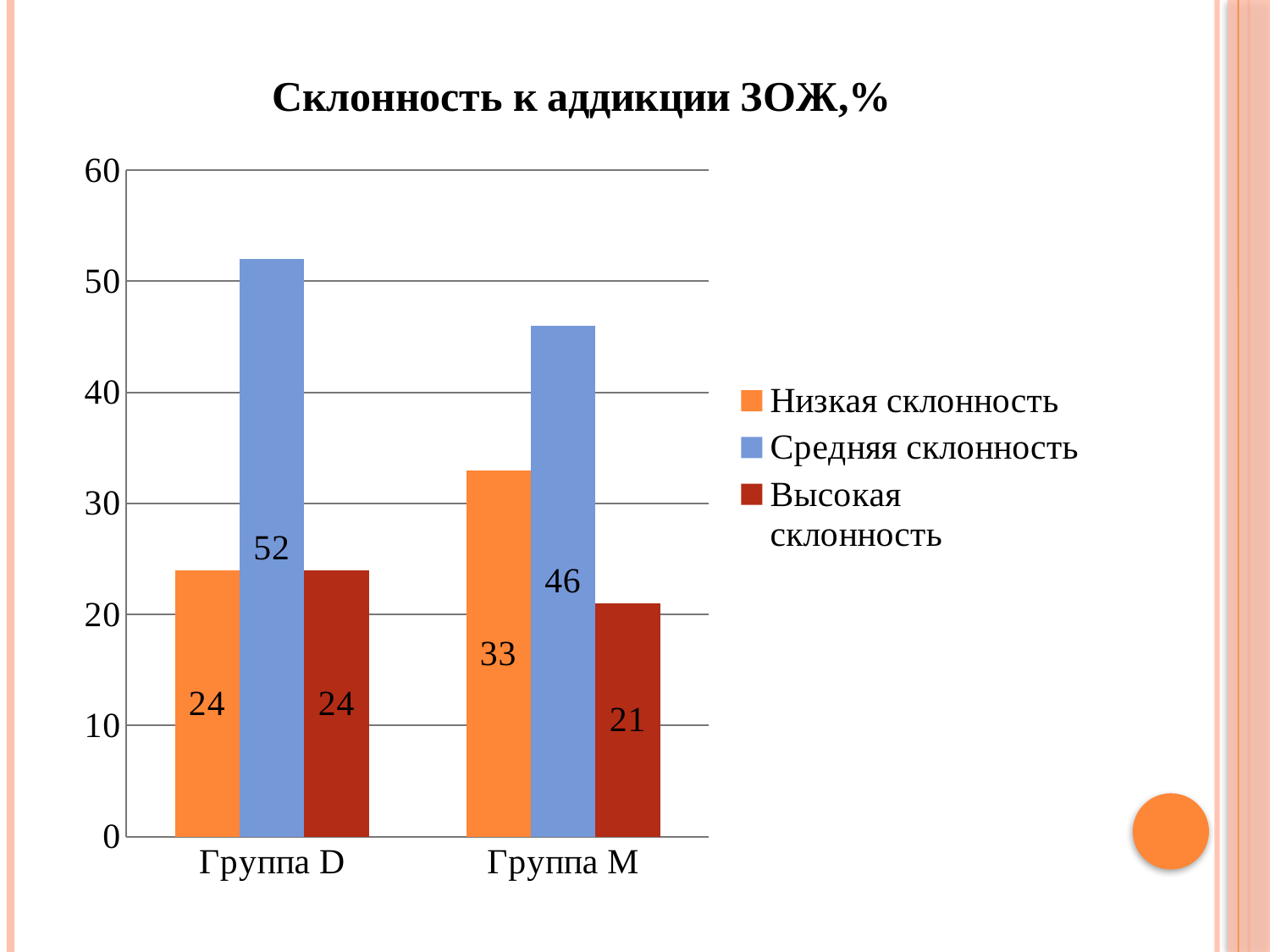
Which series has the lowest value in Группа M? Высокая склонность Which series has the highest value in Группа M? Средняя склонность Which is larger: Высокая склонность in Группа D or Высокая склонность in Группа M? Группа D What is the value for Средняя склонность in Группа D? 52 What kind of chart is shown on the slide? bar chart What is the difference between Средняя склонность in Группа D and Средняя склонность in Группа M? 6 How many series does the legend list? 3 What is the difference between Низкая склонность in Группа M and Низкая склонность in Группа D? 9 Is the value for Средняя склонность in Группа D greater or less than 50? greater How many categories are shown on the x axis? 2 What is the value for Высокая склонность in Группа M? 21 What is the value for Низкая склонность in Группа M? 33